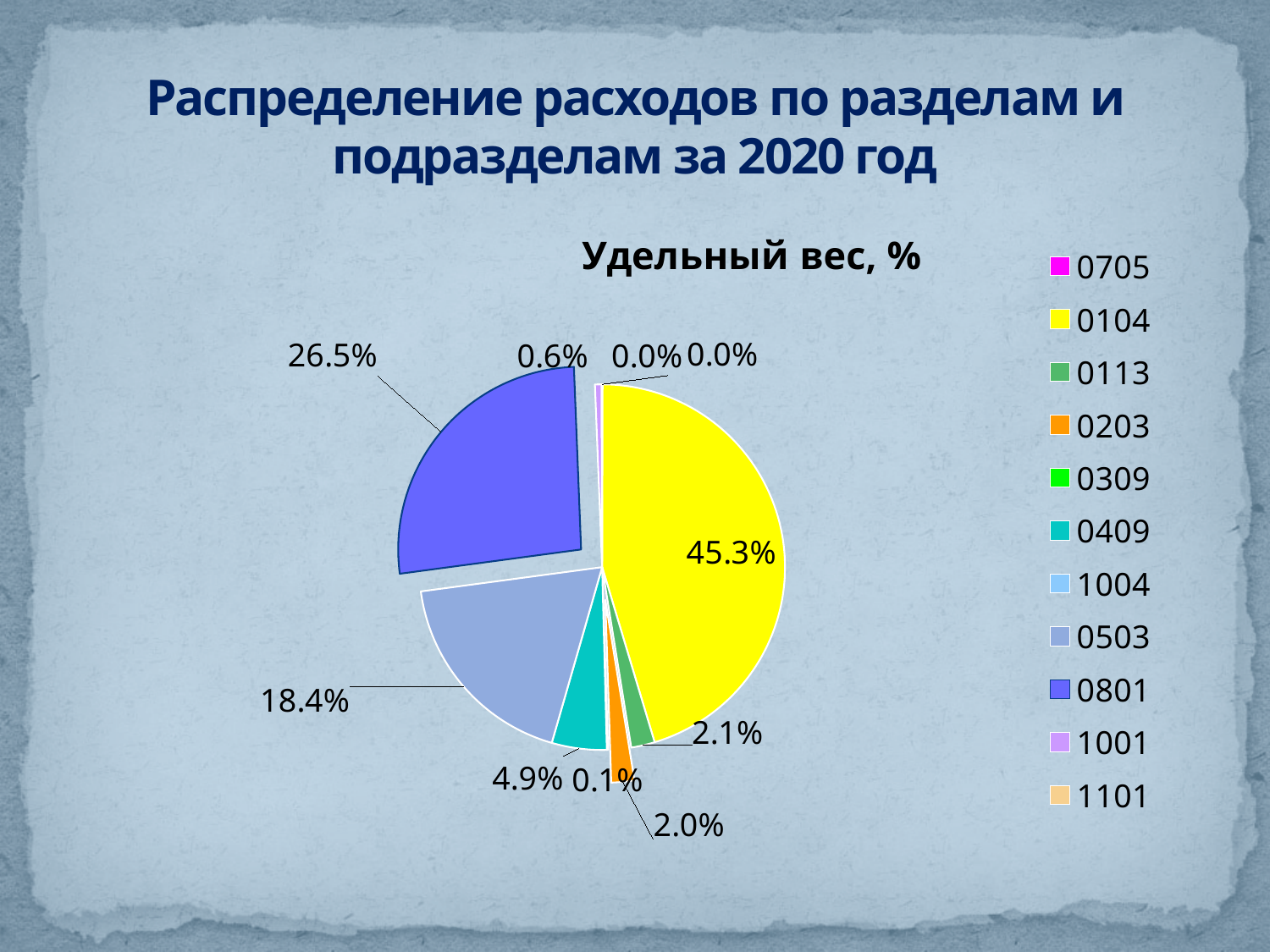
What share of the pie does section 0104 have? 45.3% What is the value shown for section 0409? 4.9% Which section has the largest share of the pie? 0104 How many entries does the legend list? 11 What is the value shown for section 0801? 26.5% Which has a larger share, 0409 or 0113? 0409 What is the difference between the shares of 0104 and 0801? 18.8% What is the combined share of 0104 and 0801? 71.8% What type of chart is shown on the slide? Pie chart What is the value shown for section 0503? 18.4% What is the difference between the shares of 0801 and 0503? 8.1% What is the title of the chart? Удельный вес, %